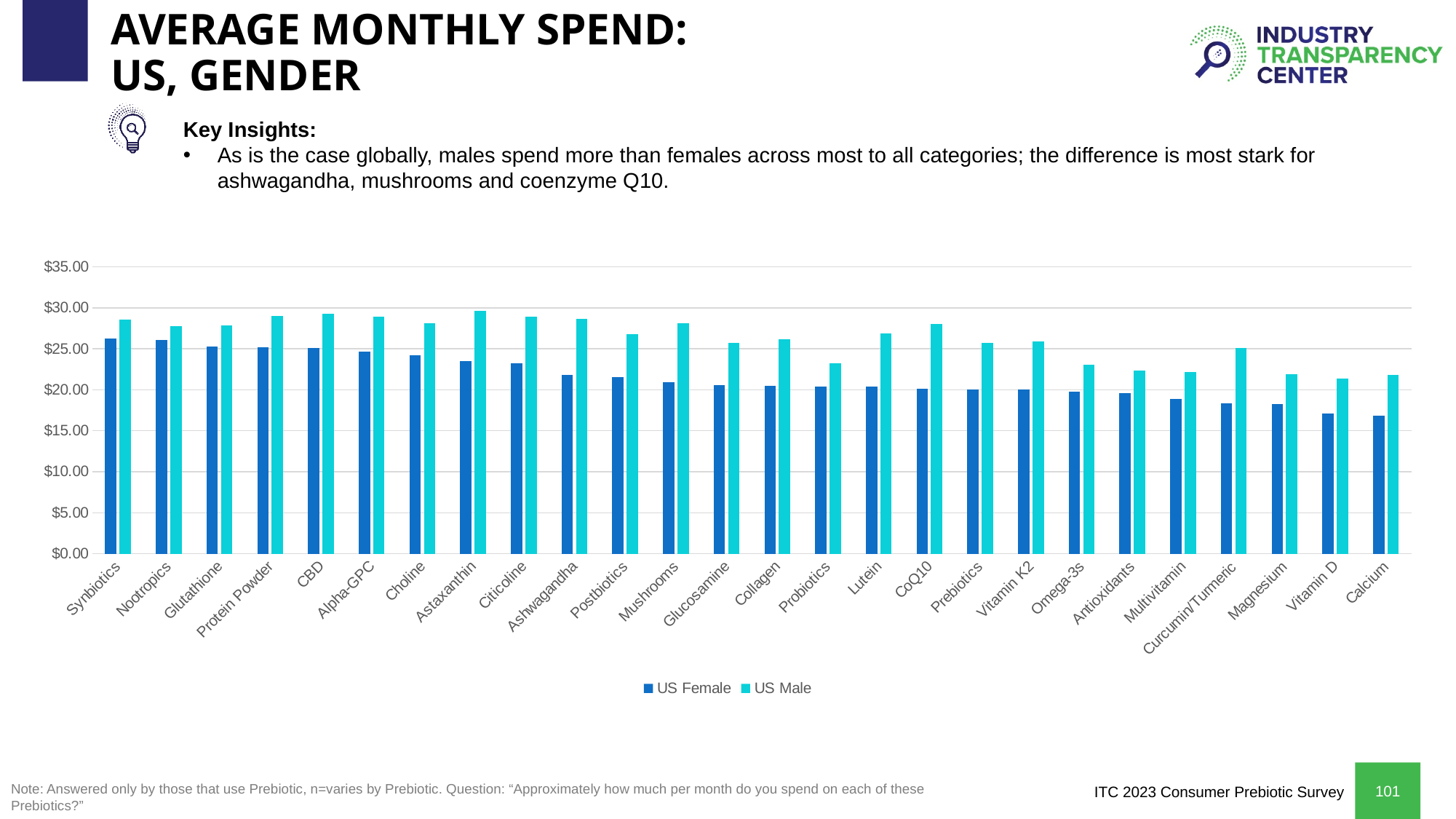
Do the US Female values generally rise or fall from left to right along the x axis? fall Is the US Female value for Synbiotics greater or less than $25.00? greater For Ashwagandha, which is larger: the US Female value or the US Male value? US Male How many categories are shown on the x axis? 26 How many series does the legend list? 2 What are the two series named in the legend? US Female and US Male Is the US Male value for Calcium greater or less than $20.00? greater Which is larger: the US Male value for Lutein or the US Male value for Probiotics? Lutein Is the US Female value for Calcium greater or less than $20.00? less What kind of chart is shown on the slide? bar chart